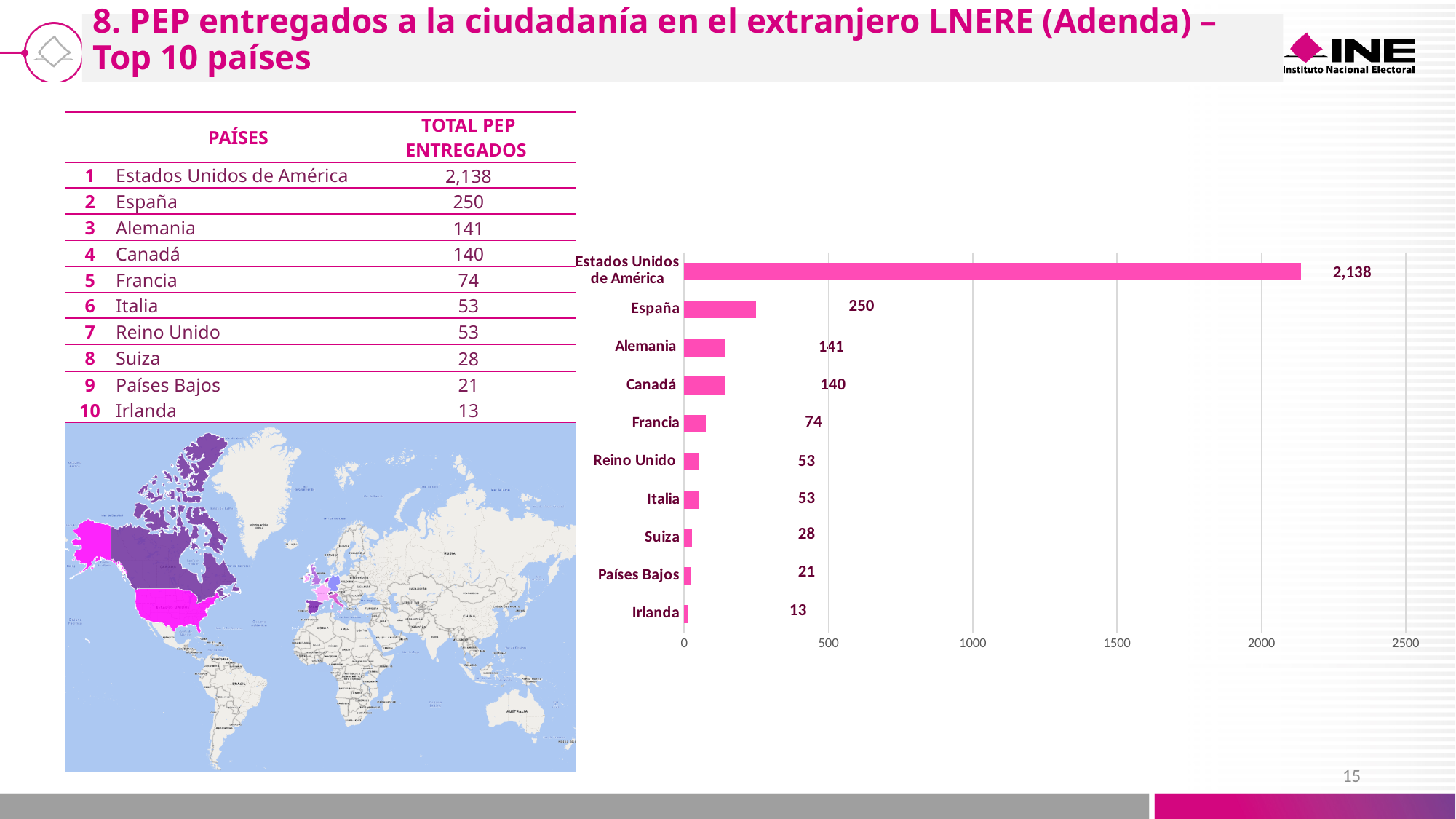
What is the value for Países Bajos in the bar chart? 21 What is the value for Irlanda in the bar chart? 13 What is the value for España in the bar chart? 250 What kind of chart is shown on the right of the slide? bar chart What is the difference between the values for Francia and Suiza in the bar chart? 46 Is the value for Estados Unidos de América in the bar chart greater or less than 2000? greater How many countries are shown in the bar chart? 10 What is the difference between the values for Estados Unidos de América and España in the bar chart? 1,888 What is the value for Canadá in the bar chart? 140 Which is larger in the bar chart, the value for Alemania or the value for Francia? Alemania Which country has the lowest value in the bar chart? Irlanda Which country has the highest value in the bar chart? Estados Unidos de América